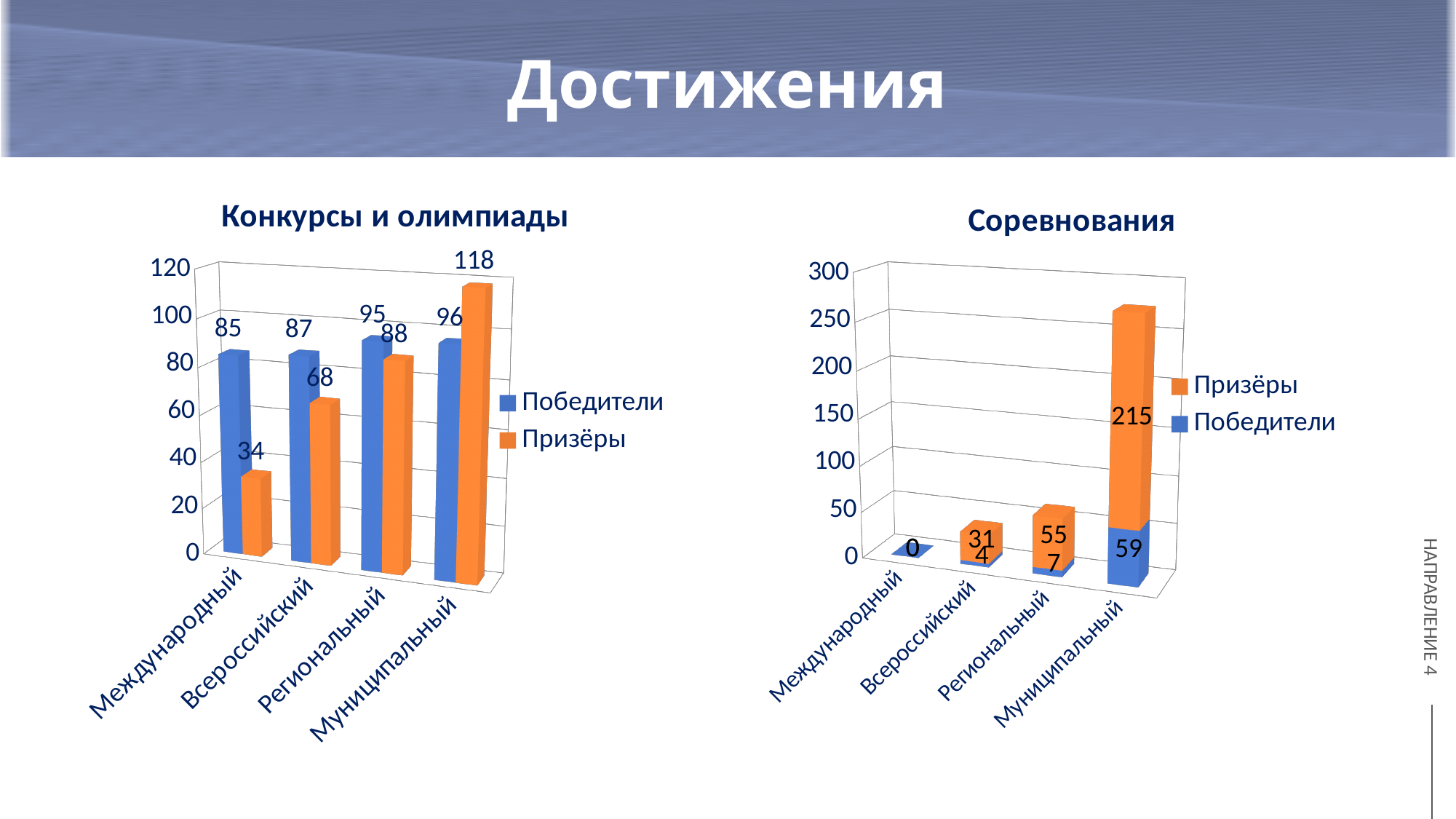
In the 'Конкурсы и олимпиады' chart, which category has the lowest value for Призёры? Международный In the 'Соревнования' chart, what is the value for Победители in the Региональный category? 7 How many categories are shown in the 'Конкурсы и олимпиады' chart? 4 In the 'Соревнования' chart, what is the value for Призёры in the Муниципальный category? 215 What kind of chart is the 'Соревнования' chart? stacked bar chart In the 'Конкурсы и олимпиады' chart, what is the value for Победители in the Международный category? 85 How many series does the legend of the 'Соревнования' chart list? 2 In the 'Конкурсы и олимпиады' chart, which is larger in the Региональный category: Победители or Призёры? Победители In the 'Конкурсы и олимпиады' chart, what is the difference between Призёры and Победители in the Всероссийский category? 19 In the 'Конкурсы и олимпиады' chart, what is the value for Призёры in the Муниципальный category? 118 In the 'Конкурсы и олимпиады' chart, do the Призёры values rise or fall from Международный to Муниципальный? rise In the 'Соревнования' chart, what is the total of the stacked bar for Муниципальный? 274